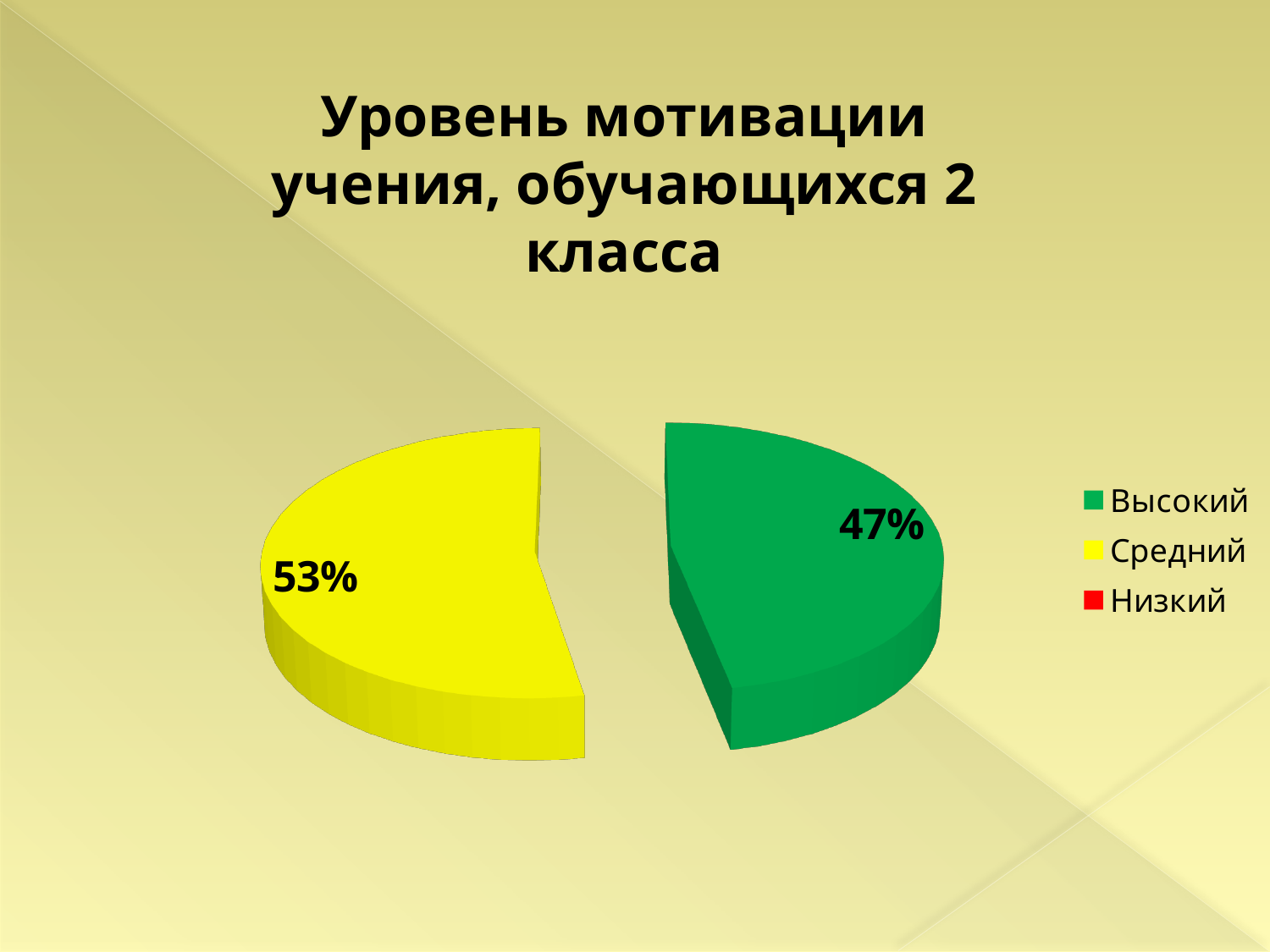
Which of the two visible slices is smaller, Высокий or Средний? Высокий What is the difference between the Средний and Высокий shares? 6% Is the value for Средний greater or less than 50%? greater What is the value for Средний? 53% How many categories does the legend list? 3 What is the title of the chart? Уровень мотивации учения, обучающихся 2 класса Which is larger, the share for Высокий or the share for Средний? Средний Is the value for Высокий greater or less than 50%? less What kind of chart is shown on the slide? pie chart What colour is the slice for Высокий? green Which category has the largest share of the pie? Средний What is the value for Высокий? 47%